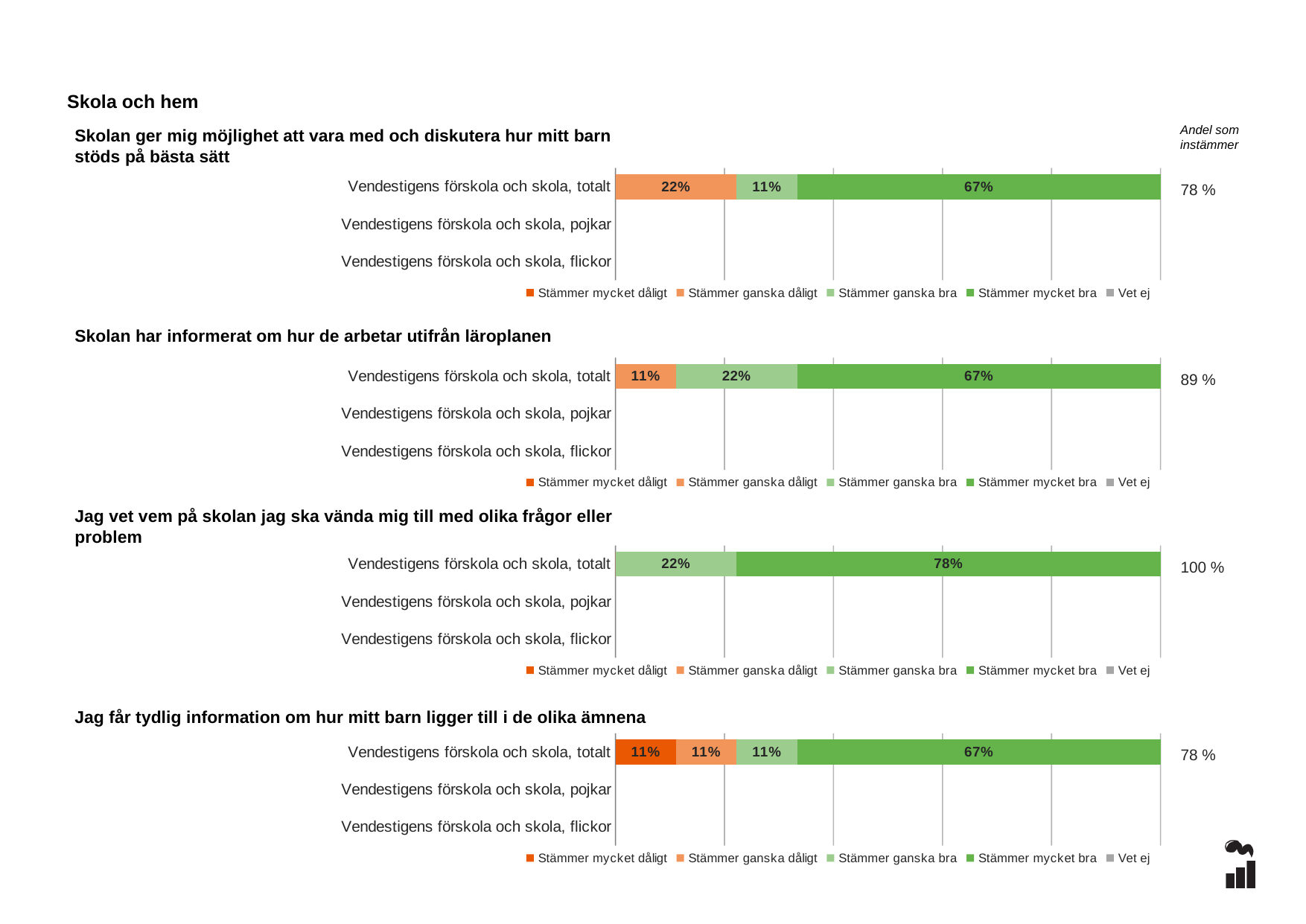
In the chart 'Jag får tydlig information om hur mitt barn ligger till i de olika ämnena', which segment is largest for 'Vendestigens förskola och skola, totalt'? Stämmer mycket bra In the chart 'Skolan har informerat om hur de arbetar utifrån läroplanen', what is the 'Andel som instämmer' shown for 'Vendestigens förskola och skola, totalt'? 89 % What kind of chart is 'Jag får tydlig information om hur mitt barn ligger till i de olika ämnena'? Stacked bar chart In the chart 'Jag vet vem på skolan jag ska vända mig till med olika frågor eller problem', what is the value of 'Stämmer mycket bra' for 'Vendestigens förskola och skola, totalt'? 78% In the chart 'Jag får tydlig information om hur mitt barn ligger till i de olika ämnena', what is the value of 'Stämmer mycket dåligt' for 'Vendestigens förskola och skola, totalt'? 11% In the chart 'Skolan har informerat om hur de arbetar utifrån läroplanen', which is larger for 'Vendestigens förskola och skola, totalt': 'Stämmer ganska dåligt' or 'Stämmer ganska bra'? Stämmer ganska bra How many series does the legend list in the chart 'Skolan ger mig möjlighet att vara med och diskutera hur mitt barn stöds på bästa sätt'? 5 In the chart 'Jag vet vem på skolan jag ska vända mig till med olika frågor eller problem', what is the difference between 'Stämmer mycket bra' and 'Stämmer ganska bra' for 'Vendestigens förskola och skola, totalt'? 56% In the chart 'Skolan ger mig möjlighet att vara med och diskutera hur mitt barn stöds på bästa sätt', what is the value of 'Stämmer ganska dåligt' for 'Vendestigens förskola och skola, totalt'? 22% In the chart 'Skolan har informerat om hur de arbetar utifrån läroplanen', what is the value of 'Stämmer ganska bra' for 'Vendestigens förskola och skola, totalt'? 22% How many categories are listed on the y axis of the chart 'Jag vet vem på skolan jag ska vända mig till med olika frågor eller problem'? 3 In the chart 'Skolan ger mig möjlighet att vara med och diskutera hur mitt barn stöds på bästa sätt', what is the value of 'Stämmer mycket bra' for 'Vendestigens förskola och skola, totalt'? 67%